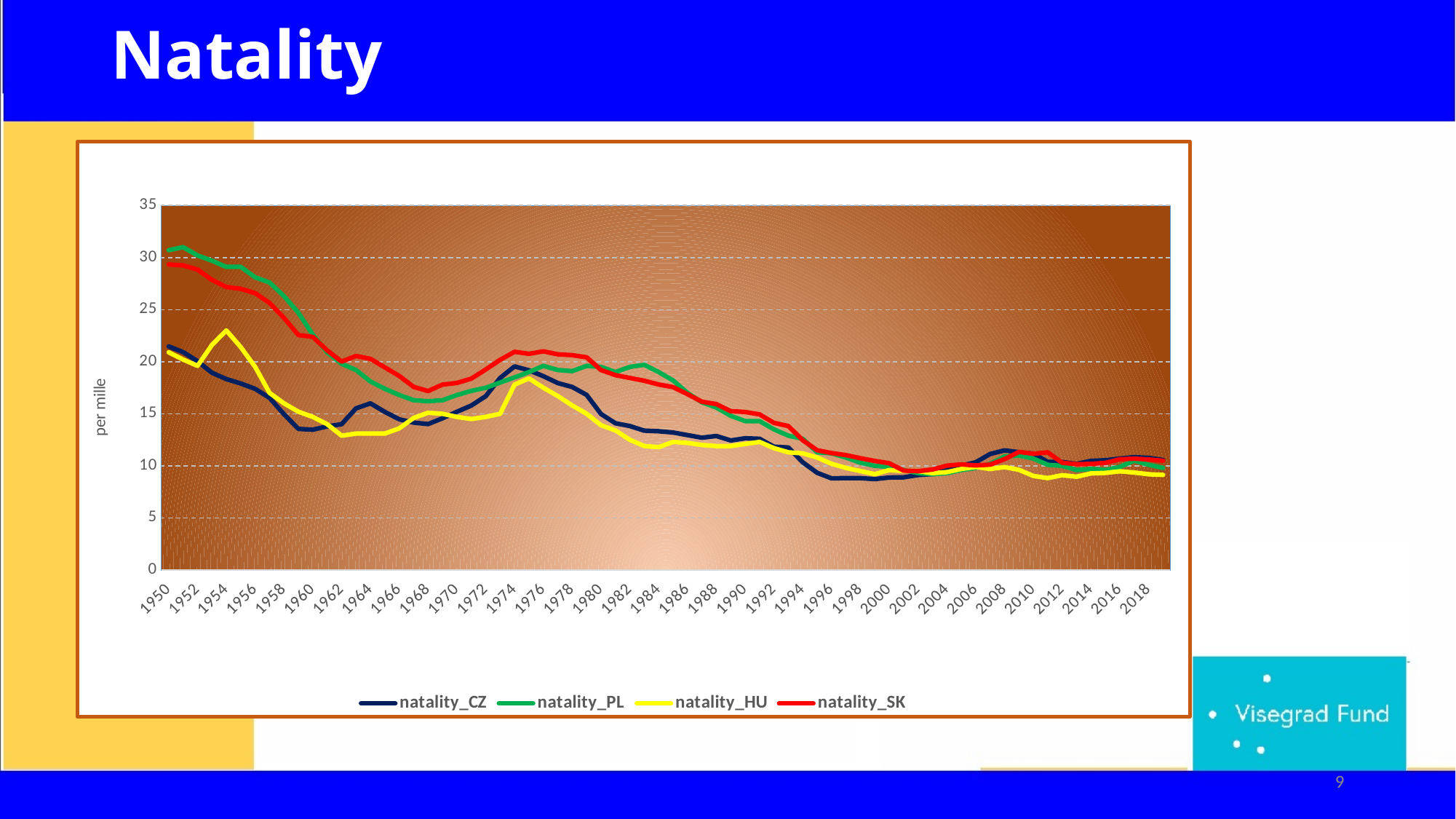
Overall, does natality_PL rise or fall from 1950 to 2018? fall How many series does the legend list? 4 Which series has the highest value in 1950? natality_PL What colour is the natality_SK line in the legend? red Is the value for natality_PL in 1950 greater or less than 30? greater What kind of chart is shown on the slide? line chart Is the value for natality_CZ in 1996 greater or less than 10? less Is the value for natality_SK in 1950 greater or less than 25? greater Which series has the highest value in 1984? natality_PL What is the label on the vertical axis? per mille